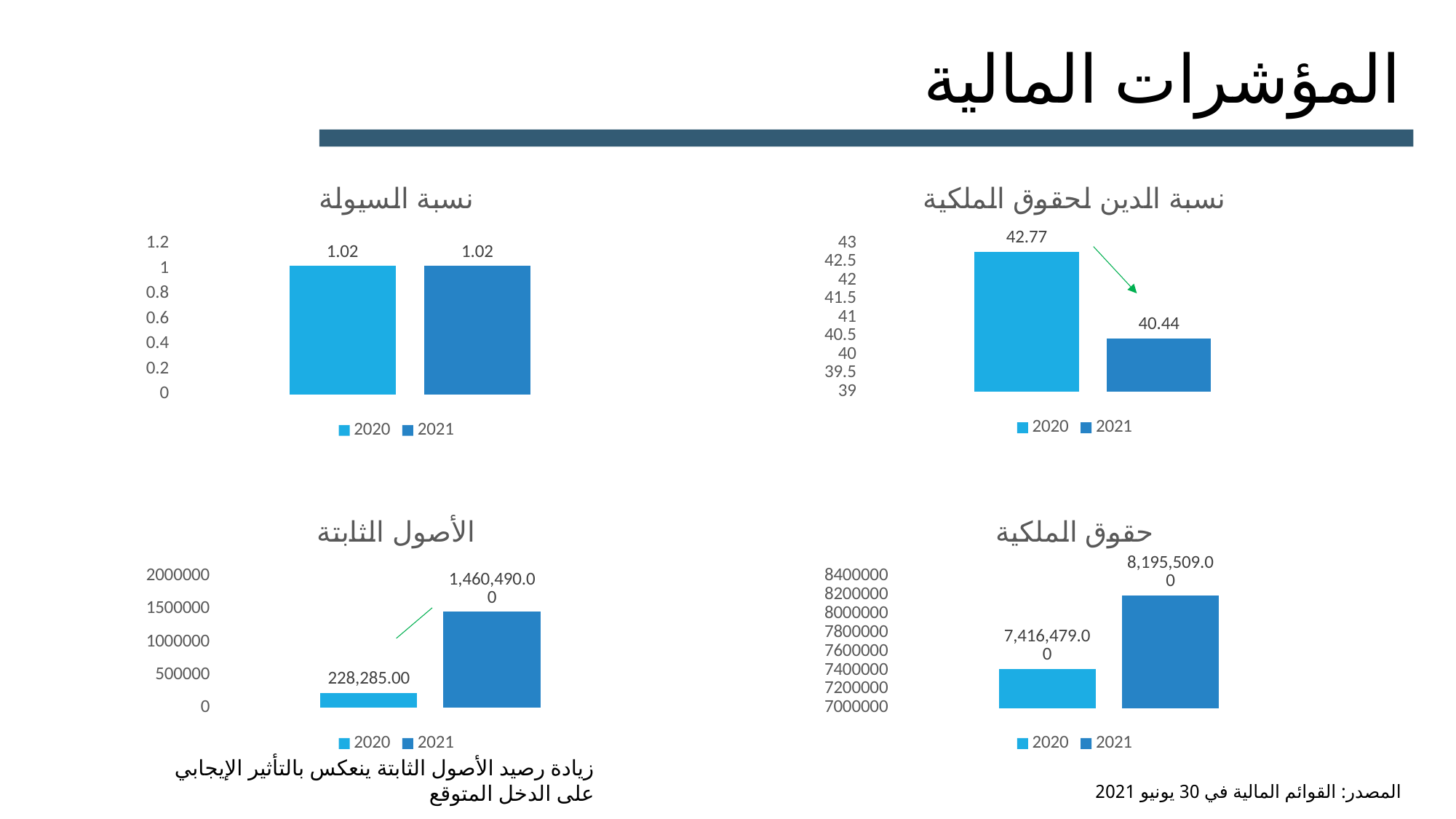
In the chart titled "حقوق الملكية" (bottom right), what is the value for 2020? 7,416,479.00 How many series does the legend of the chart titled "نسبة الدين لحقوق الملكية" (top right) list? 2 In the chart titled "نسبة الدين لحقوق الملكية" (top right), what is the value for 2020? 42.77 In the chart titled "الأصول الثابتة" (bottom left), what is the value for 2020? 228,285.00 In the chart titled "نسبة الدين لحقوق الملكية" (top right), what is the difference between the 2020 and 2021 values? 2.33 In the chart titled "الأصول الثابتة" (bottom left), what is the value for 2021? 1,460,490.00 In the chart titled "نسبة السيولة" (top left), what is the value for 2020? 1.02 In the chart titled "حقوق الملكية" (bottom right), is the value for 2020 greater or less than 7600000? less In the chart titled "نسبة السيولة" (top left), do the values rise, fall or stay the same from 2020 to 2021? stay the same In the chart titled "نسبة الدين لحقوق الملكية" (top right), what is the value for 2021? 40.44 In the chart titled "الأصول الثابتة" (bottom left), which year has the higher value? 2021 In the chart titled "حقوق الملكية" (bottom right), what is the value for 2021? 8,195,509.00